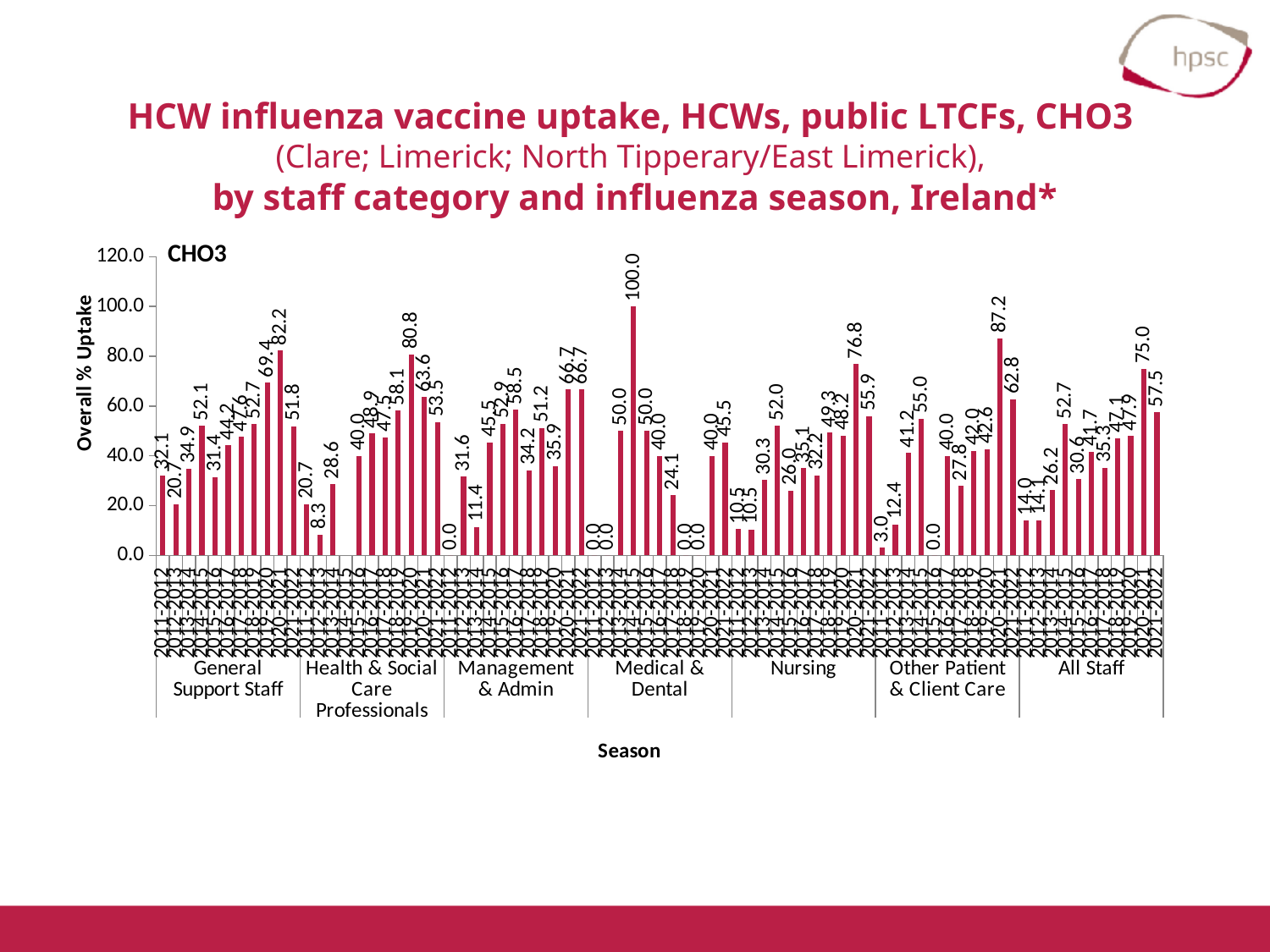
What is the highest value shown in the Medical & Dental group? 100.0 What is the highest value shown in the Health & Social Care Professionals group? 80.8 How many staff category groups are shown along the x axis? 7 What is the title of the y axis? Overall % Uptake What is the highest value shown in the General Support Staff group? 82.2 Which group has the larger peak value: General Support Staff or Nursing? General Support Staff What kind of chart is shown on the slide? bar chart What is the difference between the highest value in the Other Patient & Client Care group (87.2) and the highest value in the All Staff group (75.0)? 12.2 What is the value of the rightmost (most recent season) bar in the All Staff group? 57.5